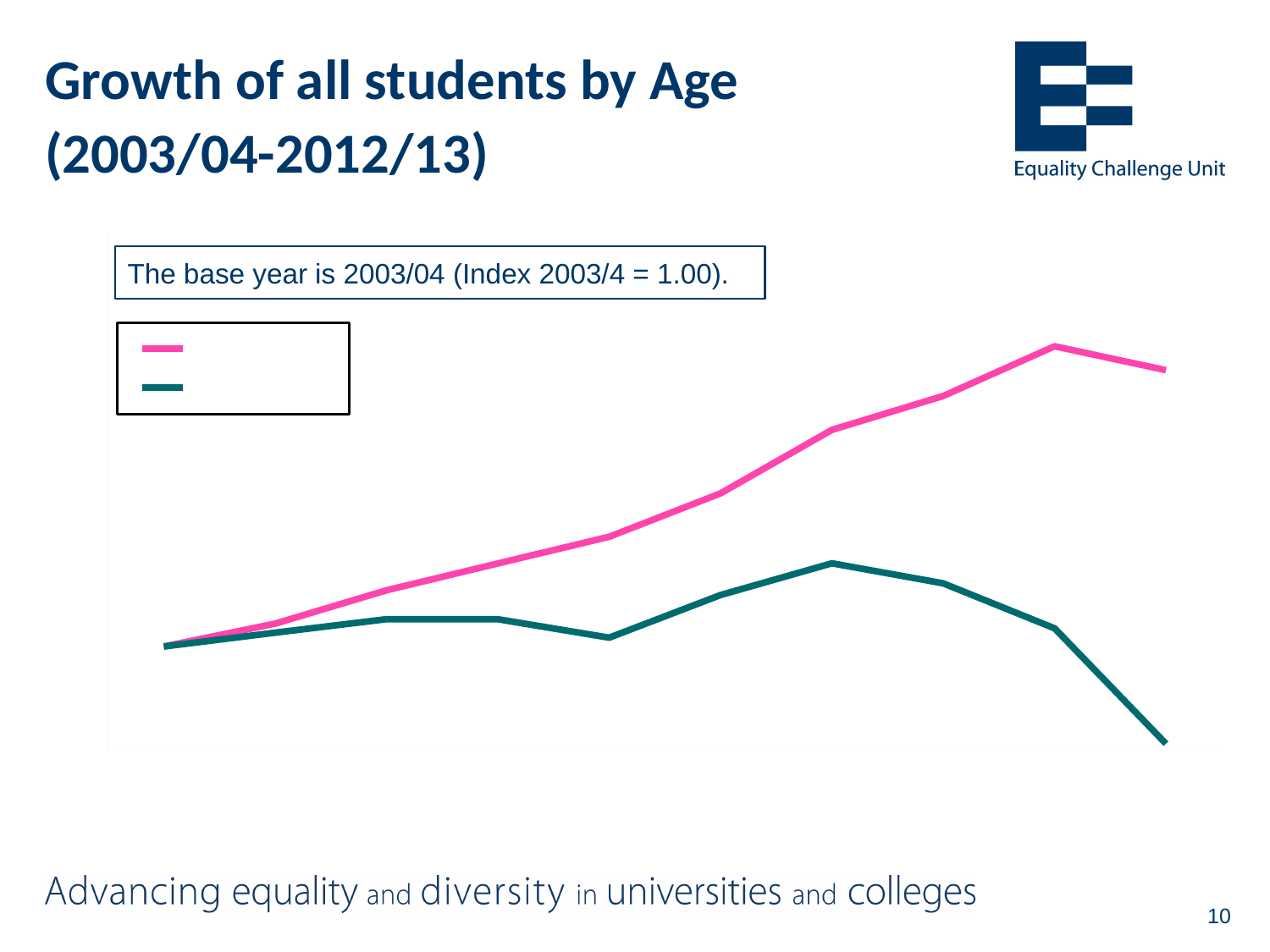
Which line reaches the lowest point on the chart? dark teal line Does the pink line generally rise or fall from left to right? rise At the rightmost point of the chart, which line is higher, the pink line or the dark teal line? pink line How many data points does each line in the chart have? 10 Do the two lines start at the same point on the left of the chart? yes According to the text box above the chart, what is the base year of the index? 2003/04 Does the dark teal line rise or fall over its last three points? fall What two colours are the lines in the chart? pink and dark teal How many series does the chart's legend list? 2 Which line reaches the highest point on the chart? pink line What kind of chart is shown on the slide? line chart